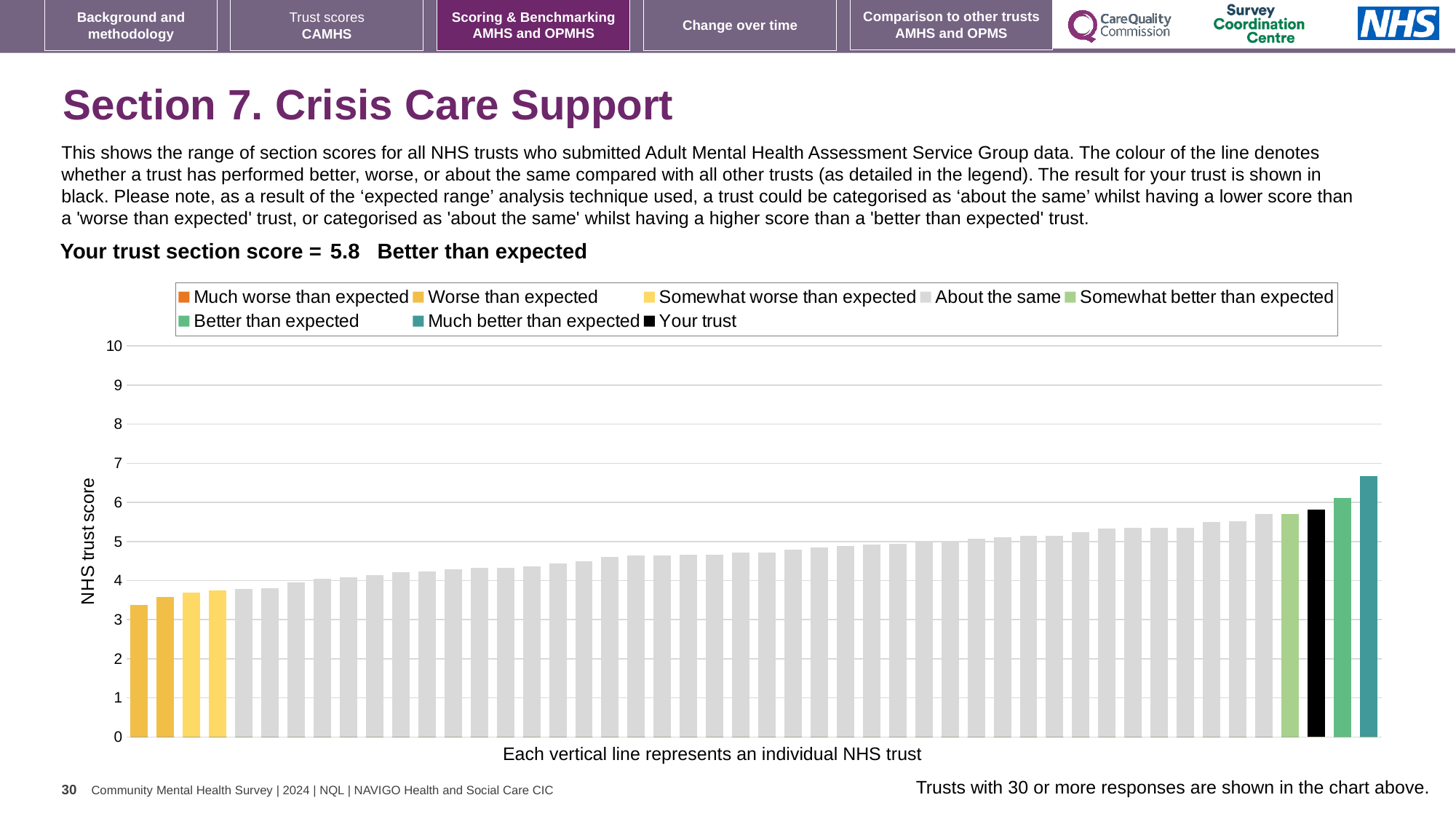
Is the value for the 'Much better than expected' bar greater or less than 6? greater What is the section score for your trust shown on the slide? 5.8 Do the bar values rise or fall from left to right across the chart? Rise What colour is used for the 'Your trust' bar in the chart? Black What is the label on the vertical axis of the chart? NHS trust score Is the value of the lowest bar in the chart greater or less than 4? less What kind of chart is shown on the slide? Bar chart Which is larger, the 'Your trust' bar or the 'Much better than expected' bar? Much better than expected Which legend category does the highest bar in the chart belong to? Much better than expected Is the value for the 'Your trust' bar greater or less than 5? greater How many entries does the chart legend list? 8 Which category is your trust placed in according to the slide? Better than expected